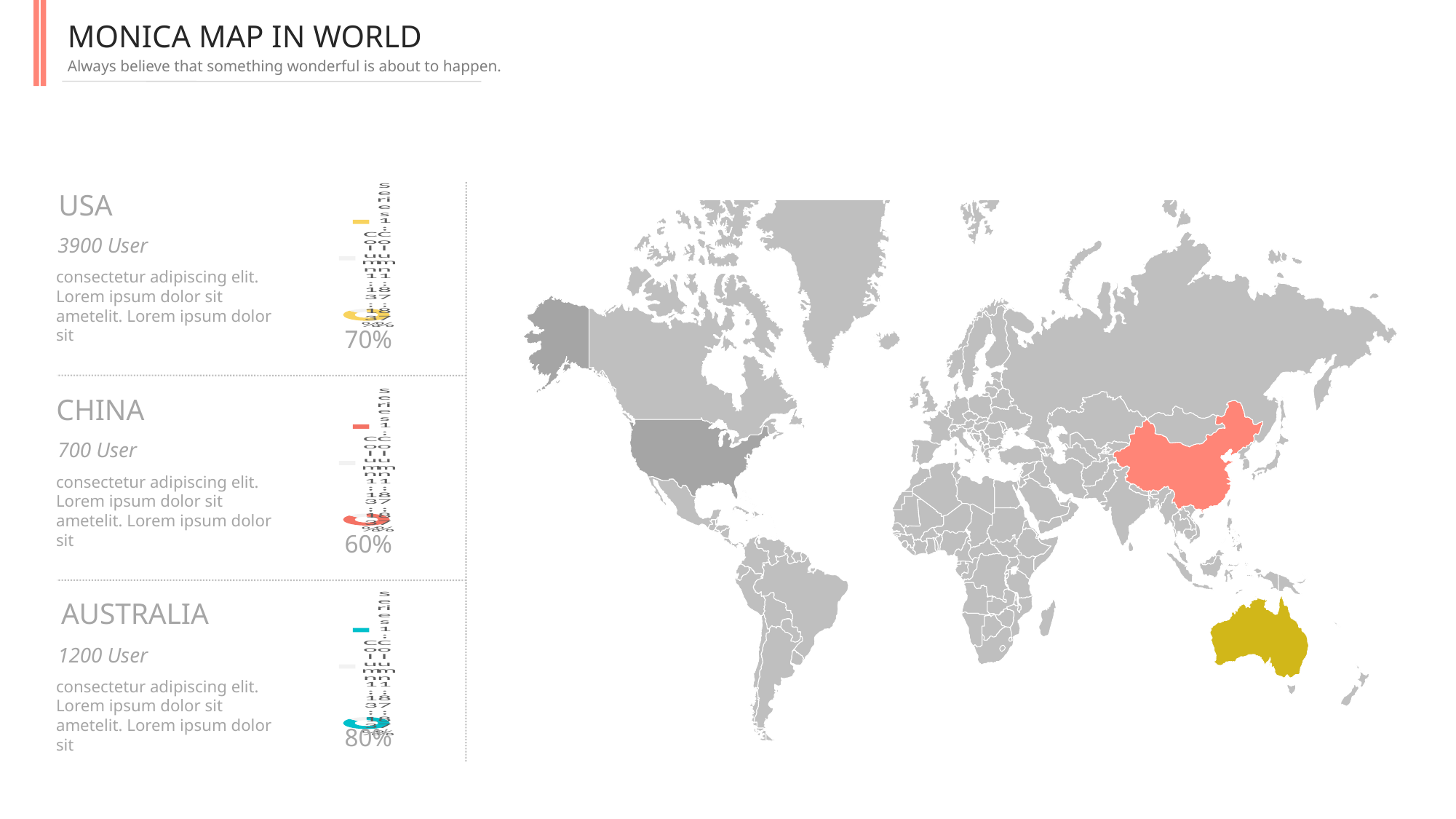
What percentage is shown beside the CHINA chart? 60% What colour is the highlighted segment of the chart beside CHINA? Red (salmon) Is the percentage shown for the USA chart larger than the percentage shown for the CHINA chart? Yes, USA (70%) is larger What percentage is shown beside the AUSTRALIA chart? 80% What kind of chart is used beside each country name on the left of the slide? Doughnut (pie) chart Which of the three country charts shows the highest percentage? AUSTRALIA Which of the three country charts shows the lowest percentage? CHINA How many small charts are shown on the left side of the slide? 3 What colour is the highlighted segment of the chart beside AUSTRALIA? Teal What is the difference between the percentage shown for AUSTRALIA and the percentage shown for CHINA? 20% What percentage is shown beside the USA chart? 70%